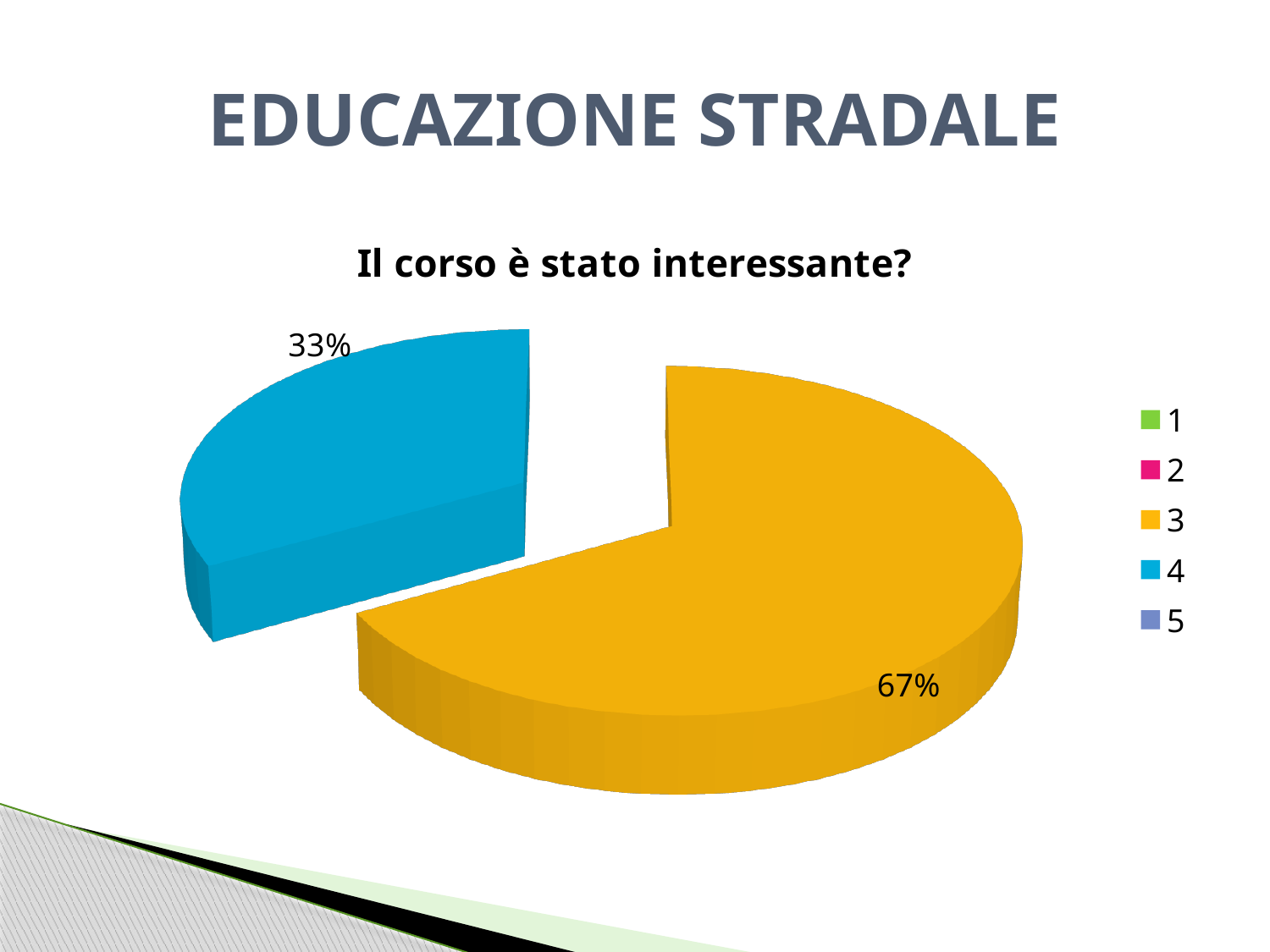
How many entries does the legend list? 5 What share of the pie does category 3 have? 67% What kind of chart is shown on the slide? pie chart Which category has the largest slice of the pie? 3 What is the difference in percentage points between the slice for category 3 and the slice for category 4? 34 How many slices are visible in the pie? 2 What is the title of the chart? Il corso è stato interessante? What share of the pie does category 4 have? 33% Which of the visible slices is smaller, category 3 or category 4? 4 Is the share for category 3 greater or less than 50%? greater What colour is the slice for category 4? blue